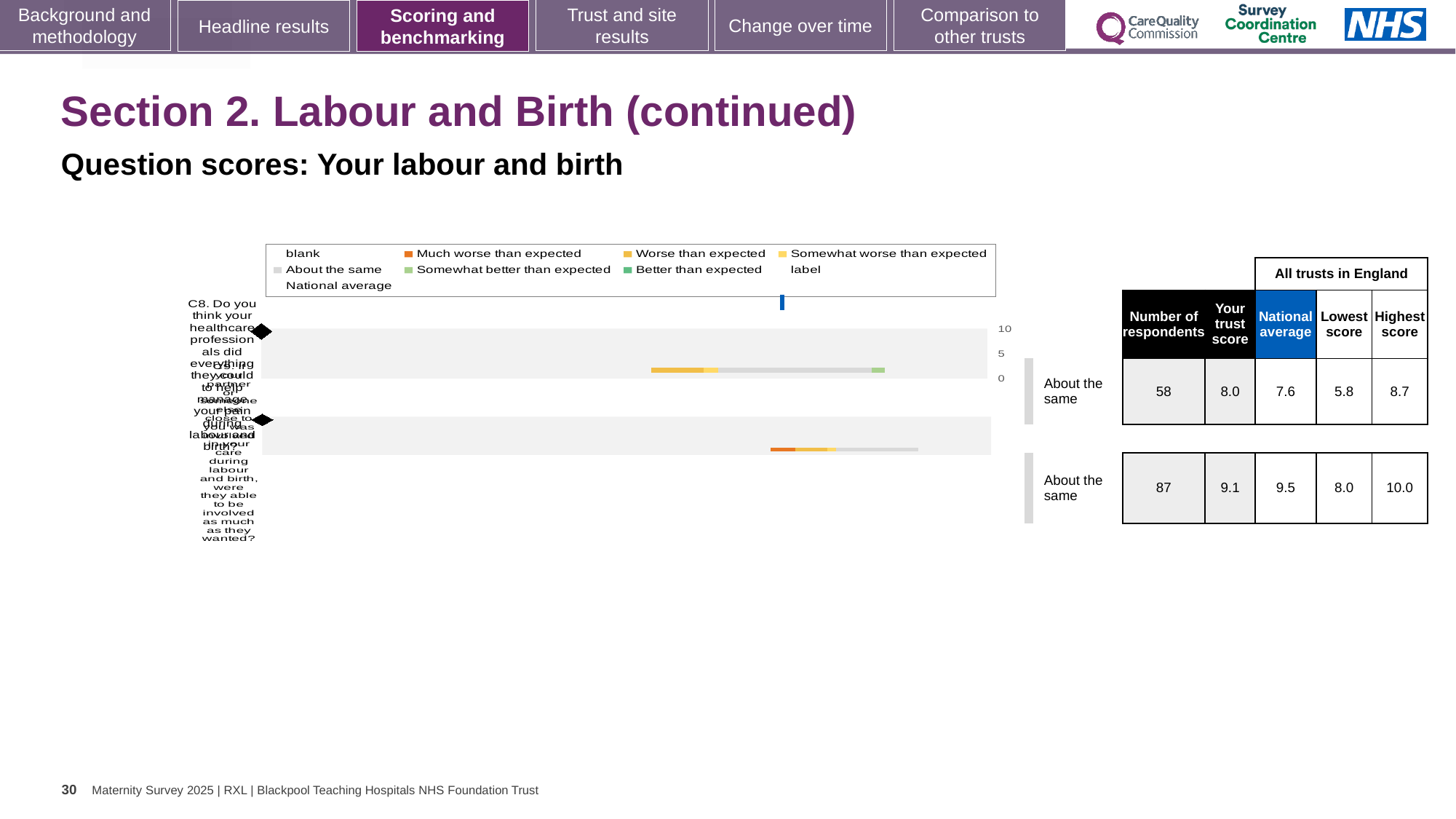
In the table beside the chart, what is the highest score across all trusts in England for the second question row (C9)? 10.0 What kind of chart is shown on the slide? bar chart In the table beside the chart, what is the number of respondents for the first question row (C8)? 58 What benchmark category is shown for both question rows on the chart? About the same How many question rows (bars) does the chart show? 2 In the table beside the chart, which is larger for the first question row (C8): the trust score or the national average? trust score What is the highest value shown on the chart's score axis? 10 In the table beside the chart, what is the lowest score across all trusts in England for the first question row (C8)? 5.8 In the table beside the chart, what is the trust score for the first question row (C8)? 8.0 Which legend entry is shown in dark orange? Much worse than expected In the table beside the chart, what is the national average for the second question row (C9)? 9.5 In the table beside the chart, what is the difference between the trust score and the national average for the second question row (C9)? 0.4